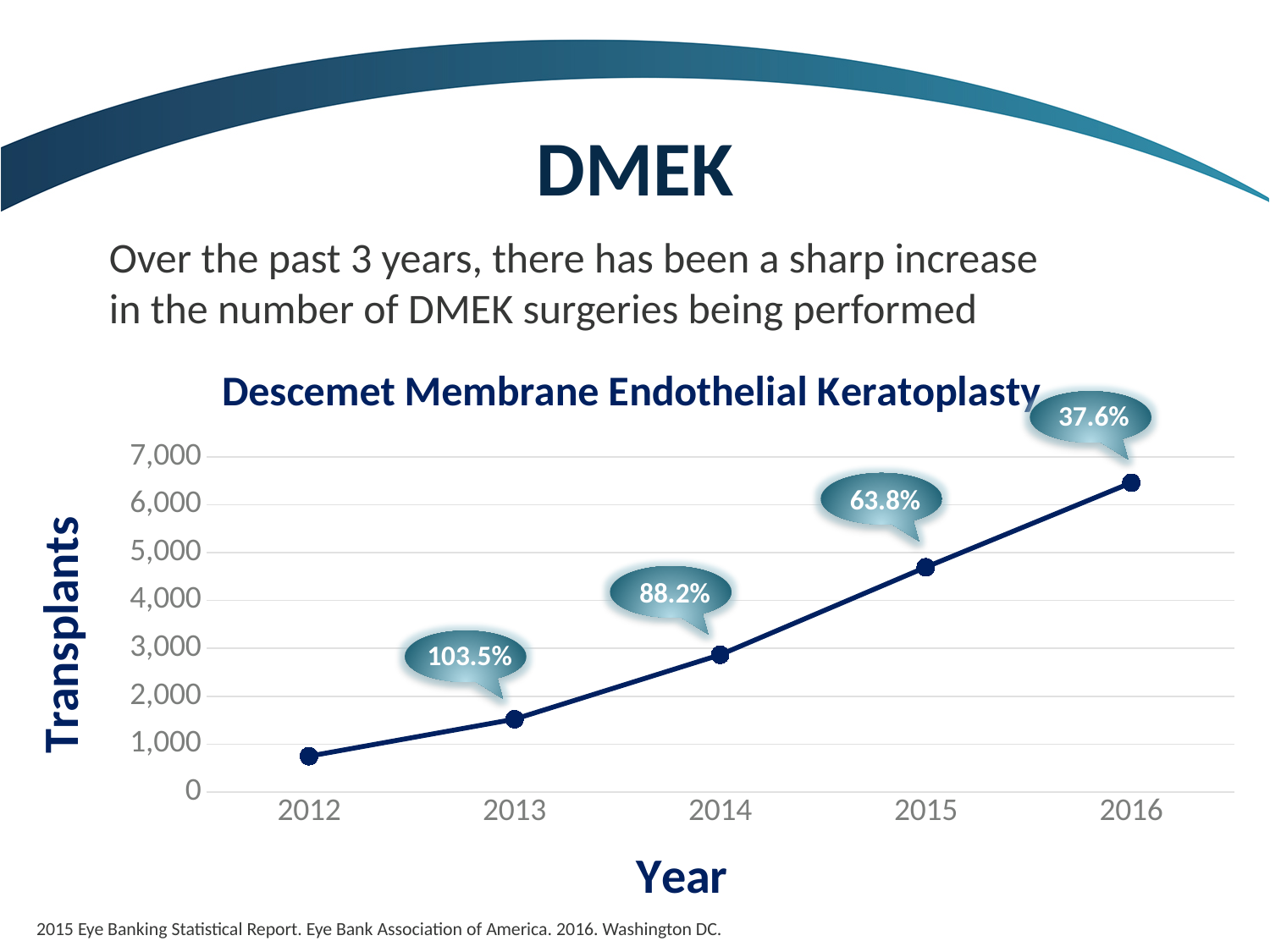
What percentage increase is shown in the callout for 2016? 37.6% Is the number of transplants in 2012 greater or less than 1,000? less Is the number of transplants in 2016 greater or less than 6,000? greater What percentage increase is shown in the callout for 2013? 103.5% What kind of chart is shown on the slide? line chart Do the number of transplants rise or fall from 2012 to 2016? rise Which year has the highest number of transplants? 2016 What percentage increase is shown in the callout for 2015? 63.8% How many years are plotted on the chart? 5 Which year has the lowest number of transplants? 2012 What is the title of the chart? Descemet Membrane Endothelial Keratoplasty What is the label of the vertical axis? Transplants